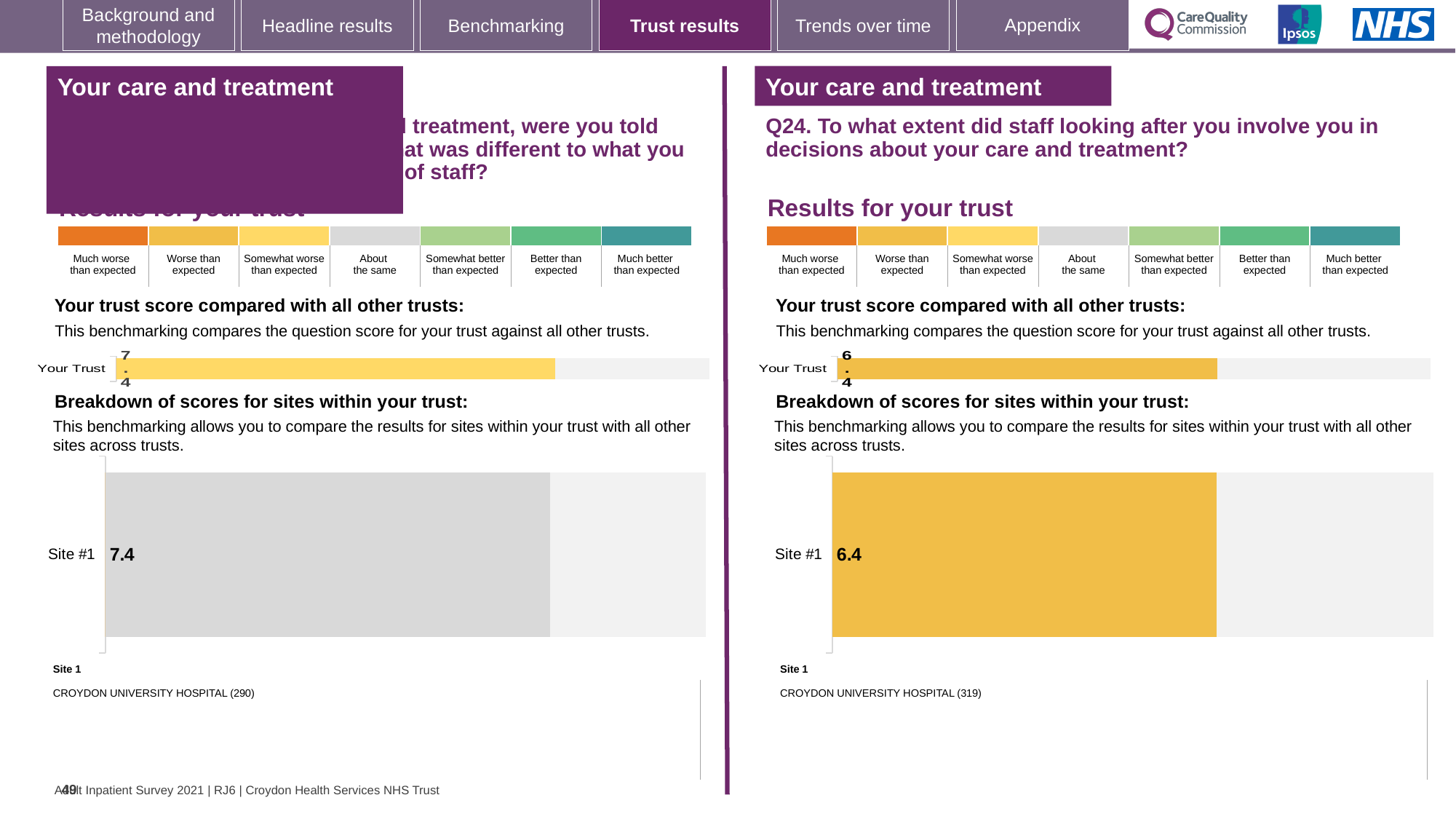
Which is larger: the Site #1 score on the left-hand chart or the Site #1 score on the right-hand chart for Q24? Left-hand chart (7.4) On the left-hand site breakdown chart, what is the score for Site #1? 7.4 How many sites are shown in the site breakdown chart on the right-hand side for Q24? 1 How many sites are shown in the site breakdown chart on the left-hand side? 1 On the left-hand chart, what is the 'Your Trust' score? 7.4 On the right-hand site breakdown chart for Q24, what is the score for Site #1? 6.4 What is the difference between the Site #1 score on the left-hand chart and the Site #1 score on the right-hand chart for Q24? 1.0 What type of chart is used to show the 'Your Trust' score on the right-hand side for Q24? Bar chart On the right-hand chart for Q24, what is the 'Your Trust' score? 6.4 On the left-hand site breakdown chart, which site is Site #1? CROYDON UNIVERSITY HOSPITAL (290) On the right-hand site breakdown chart for Q24, which site is Site #1? CROYDON UNIVERSITY HOSPITAL (319) Is the Site #1 score on the right-hand chart for Q24 greater or less than 7? less